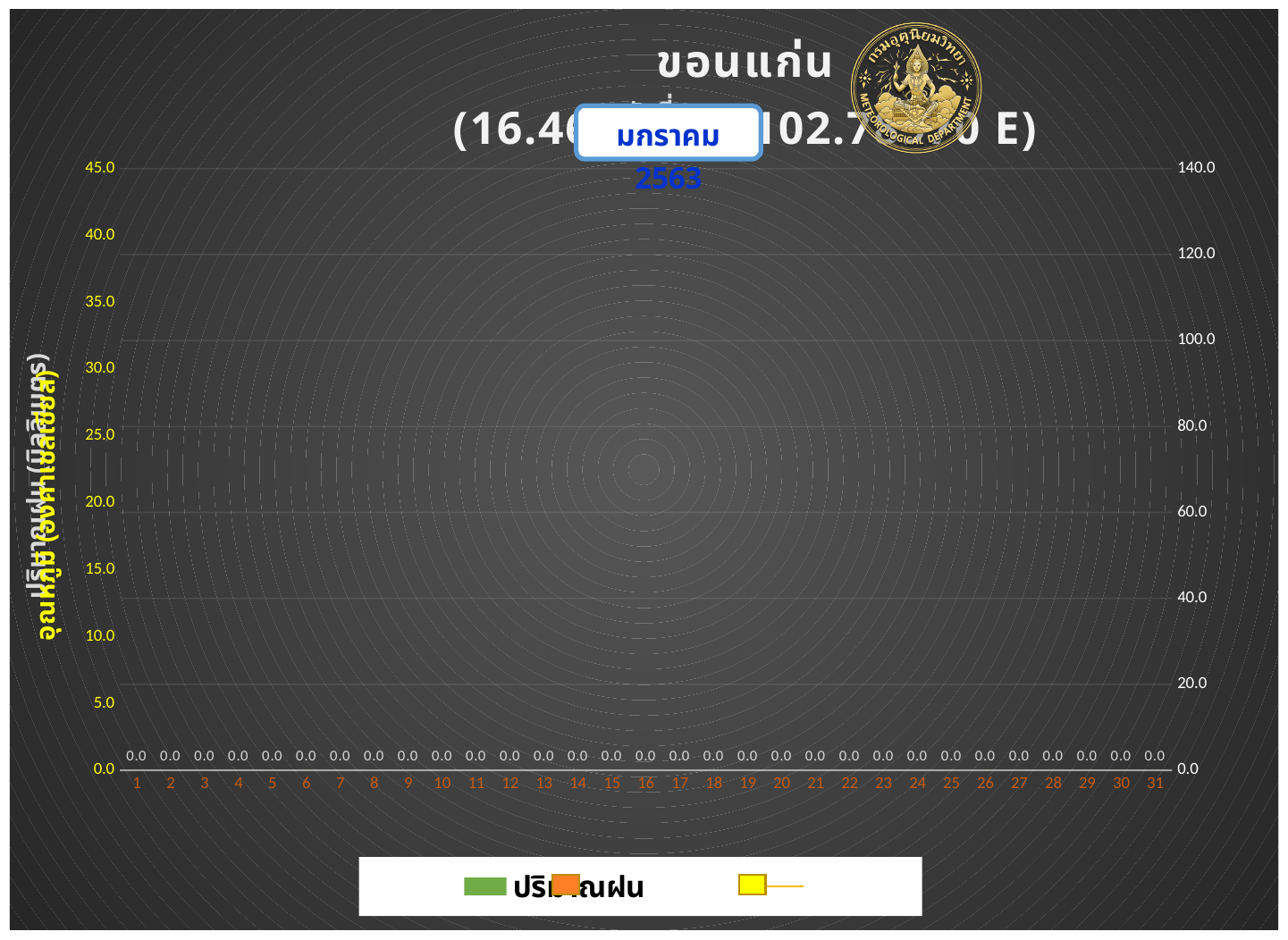
What is the highest tick value on the right vertical axis? 140.0 What is the data label shown for day 1? 0.0 Do the plotted values rise, fall, or stay flat from day 1 to day 31? stay flat What is the difference between the values for day 5 and day 20? 0.0 What is the data label shown for day 31? 0.0 Is the value for day 25 greater or less than 20.0? less What is the highest tick value on the left vertical axis? 45.0 Is the value for day 10 greater or less than 5.0? less What is the data label shown for day 15? 0.0 How many days (categories) are shown along the x axis? 31